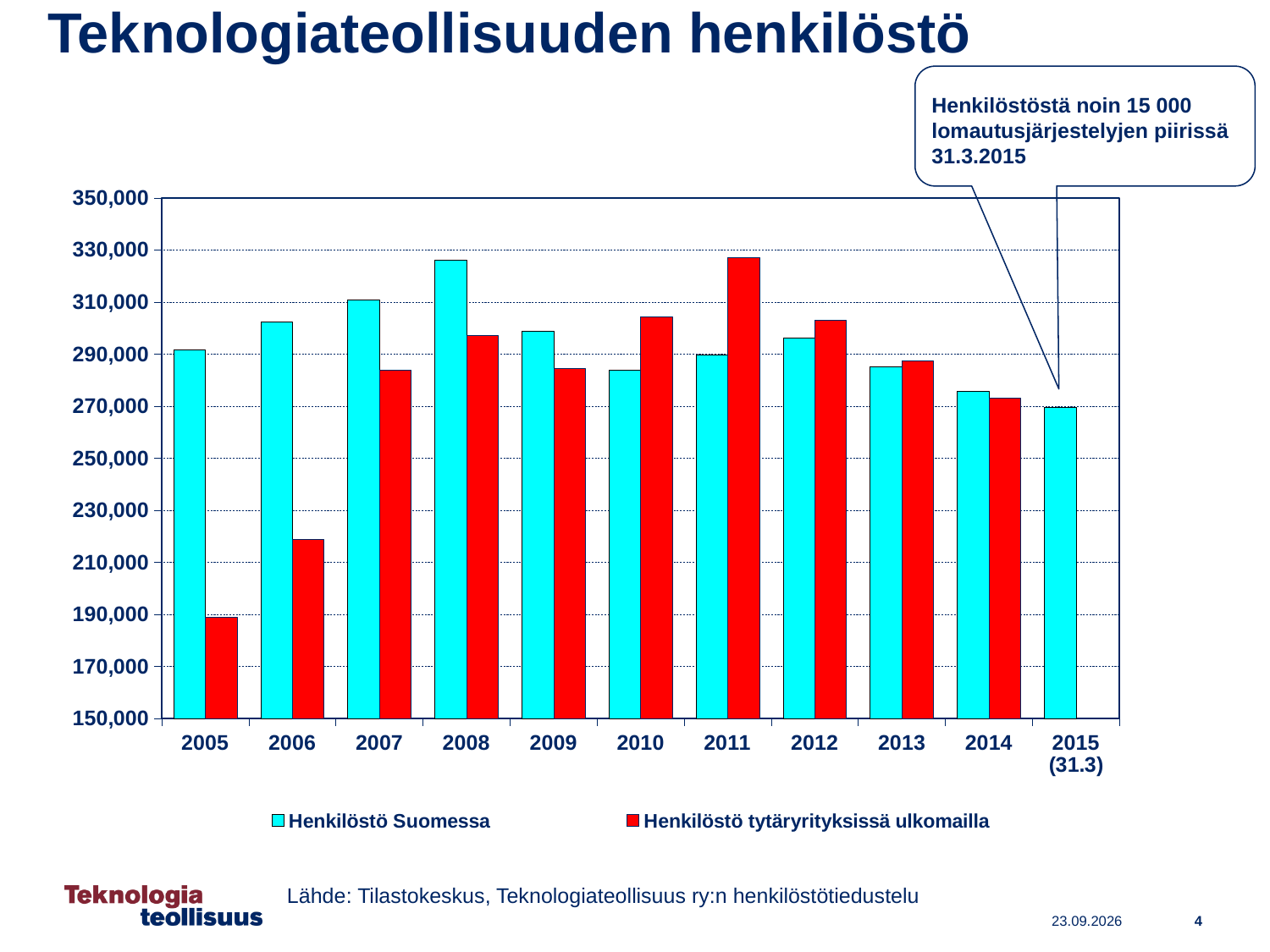
In which year is the value for Henkilöstö Suomessa highest? 2008 In 2005, which is larger: Henkilöstö Suomessa or Henkilöstö tytäryrityksissä ulkomailla? Henkilöstö Suomessa Is the value for Henkilöstö tytäryrityksissä ulkomailla in 2006 greater or less than 230,000? less In which year is the value for Henkilöstö tytäryrityksissä ulkomailla highest? 2011 Is the value for Henkilöstö Suomessa in 2008 greater or less than 310,000? greater Does the value for Henkilöstö Suomessa rise or fall from 2012 to 2015 (31.3)? Fall How many year categories are shown on the x axis? 11 How many series does the legend list? 2 In which year is the value for Henkilöstö tytäryrityksissä ulkomailla lowest? 2005 In which year is the value for Henkilöstö Suomessa lowest? 2015 (31.3) In 2011, which is larger: Henkilöstö Suomessa or Henkilöstö tytäryrityksissä ulkomailla? Henkilöstö tytäryrityksissä ulkomailla What kind of chart is shown on the slide? Bar chart